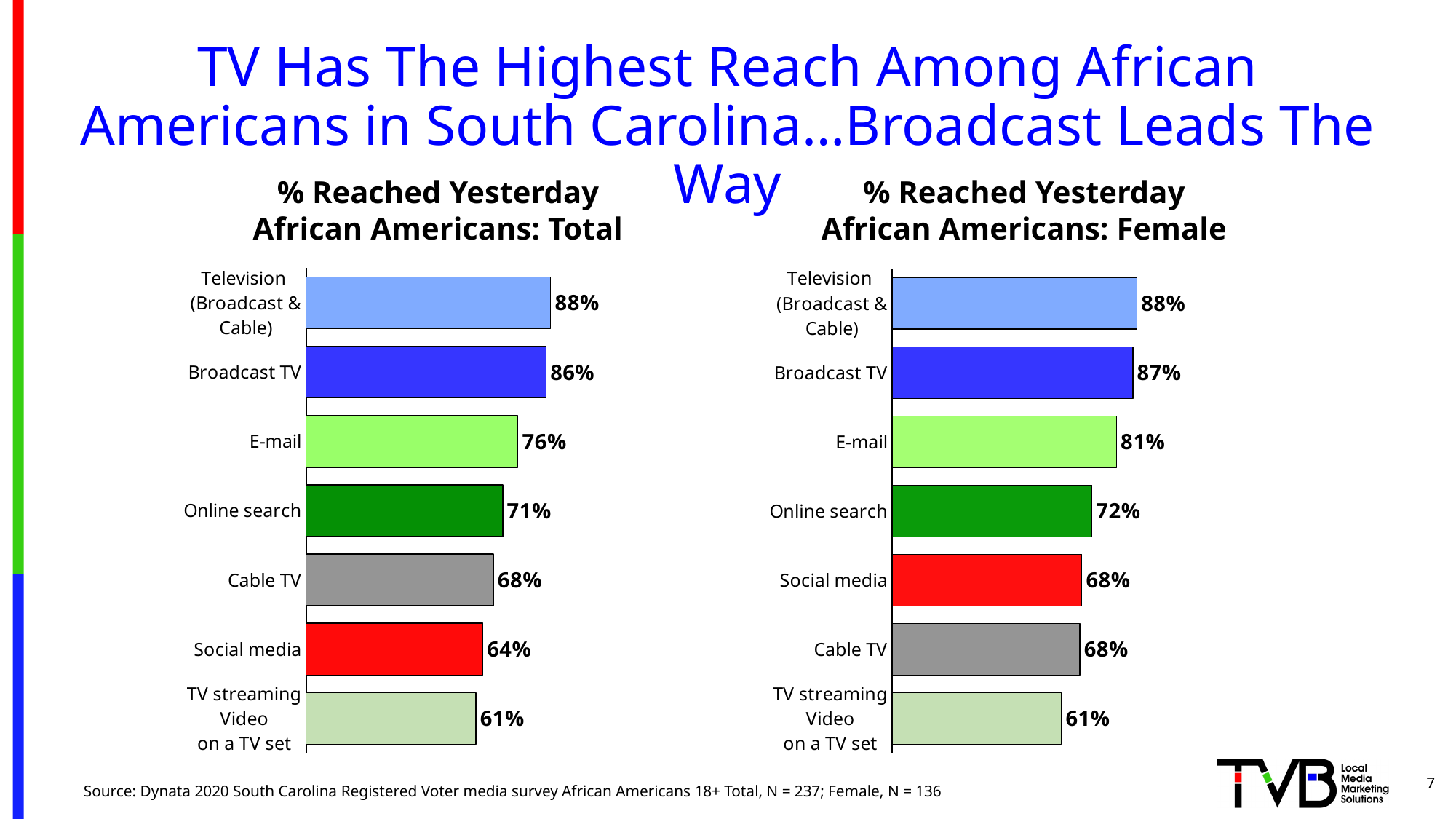
In the '% Reached Yesterday African Americans: Female' chart, what is the value for Social media? 68% In the '% Reached Yesterday African Americans: Total' chart, what is the value for Cable TV? 68% Which is larger: E-mail in the Total chart or E-mail in the Female chart? E-mail in the Female chart How many categories are shown in the '% Reached Yesterday African Americans: Total' chart? 7 In the '% Reached Yesterday African Americans: Female' chart, what is the value for Broadcast TV? 87% In the '% Reached Yesterday African Americans: Female' chart, what is the difference between E-mail and Online search? 9% In the '% Reached Yesterday African Americans: Female' chart, which category has the lowest value? TV streaming Video on a TV set In the '% Reached Yesterday African Americans: Total' chart, what is the value for E-mail? 76% In the '% Reached Yesterday African Americans: Total' chart, which category has the highest value? Television (Broadcast & Cable) In the '% Reached Yesterday African Americans: Total' chart, what colour is the Social media bar? Red In the '% Reached Yesterday African Americans: Total' chart, what is the difference between Broadcast TV and Social media? 22% What kind of chart is the '% Reached Yesterday African Americans: Female' chart? Bar chart